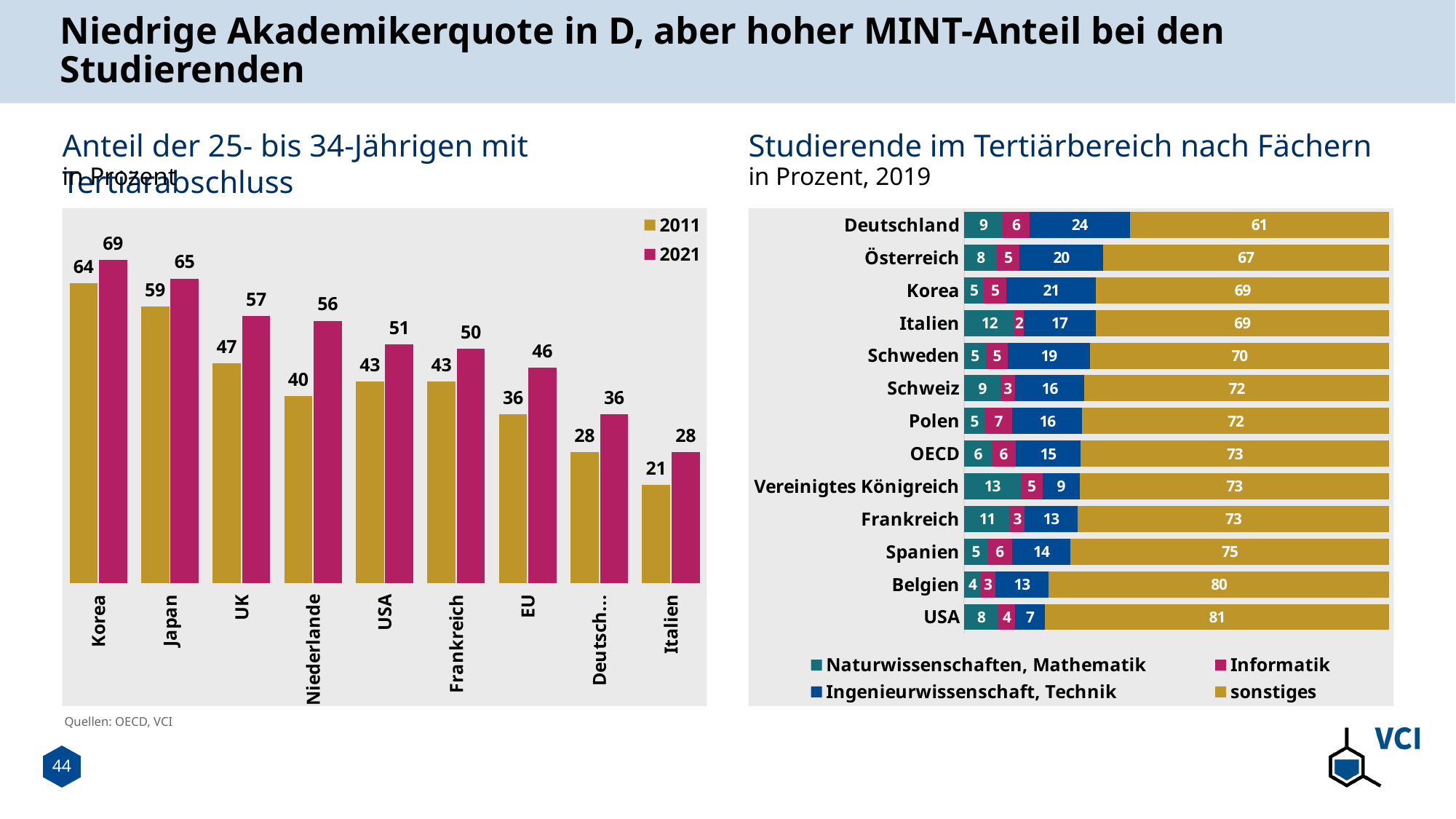
In the left chart (Anteil der 25- bis 34-Jährigen mit Tertiärabschluss), what is the 2021 value for Korea? 69 In the left chart (Anteil der 25- bis 34-Jährigen mit Tertiärabschluss), how many countries or regions are shown on the x axis? 9 In the left chart (Anteil der 25- bis 34-Jährigen mit Tertiärabschluss), by how much did the value for Niederlande increase from 2011 to 2021? 16 In the right chart (Studierende im Tertiärbereich nach Fächern), what is the total of the Deutschland bar? 100 In the right chart (Studierende im Tertiärbereich nach Fächern), which country has the highest Naturwissenschaften, Mathematik share? Vereinigtes Königreich In the right chart (Studierende im Tertiärbereich nach Fächern), what is the Ingenieurwissenschaft, Technik share for Deutschland? 24 In the right chart (Studierende im Tertiärbereich nach Fächern), how many countries or groups are listed? 13 In the right chart (Studierende im Tertiärbereich nach Fächern), what is the sonstiges share for USA? 81 In the left chart (Anteil der 25- bis 34-Jährigen mit Tertiärabschluss), how many series does the legend list? 2 In the left chart (Anteil der 25- bis 34-Jährigen mit Tertiärabschluss), which country has the lowest 2021 value? Italien What type of chart is the right chart (Studierende im Tertiärbereich nach Fächern)? Stacked bar chart In the left chart (Anteil der 25- bis 34-Jährigen mit Tertiärabschluss), what is the 2011 value for Italien? 21